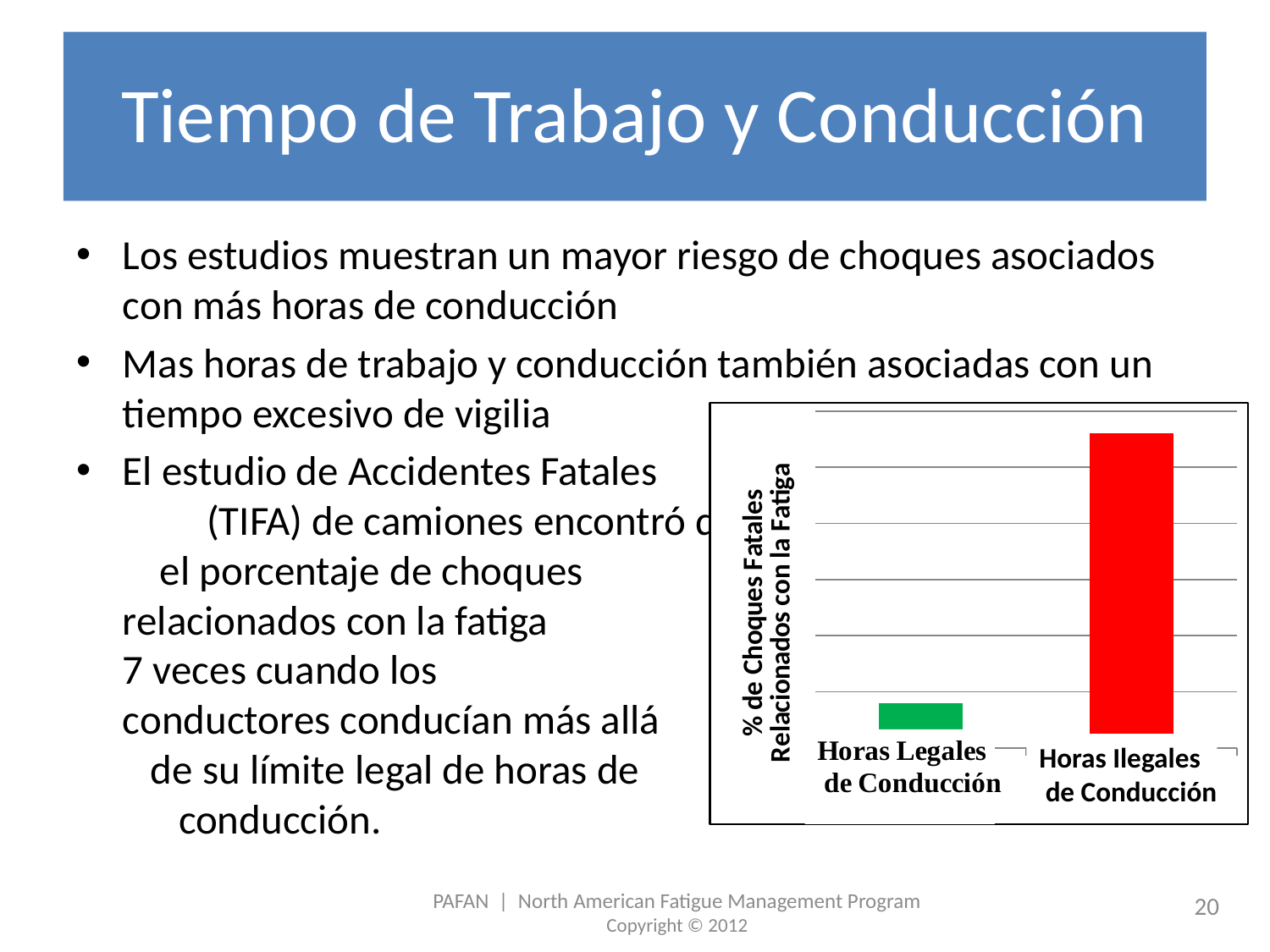
What kind of chart is shown on the slide? bar chart What colour is the bar for Horas Ilegales de Conducción? red How many categories are plotted in the chart? 2 Which is larger, the bar for Horas Legales de Conducción or the bar for Horas Ilegales de Conducción? Horas Ilegales de Conducción Which category has the lowest bar in the chart? Horas Legales de Conducción What is the label on the vertical axis of the chart? % de Choques Fatales Relacionados con la Fatiga Which category has the highest bar in the chart? Horas Ilegales de Conducción